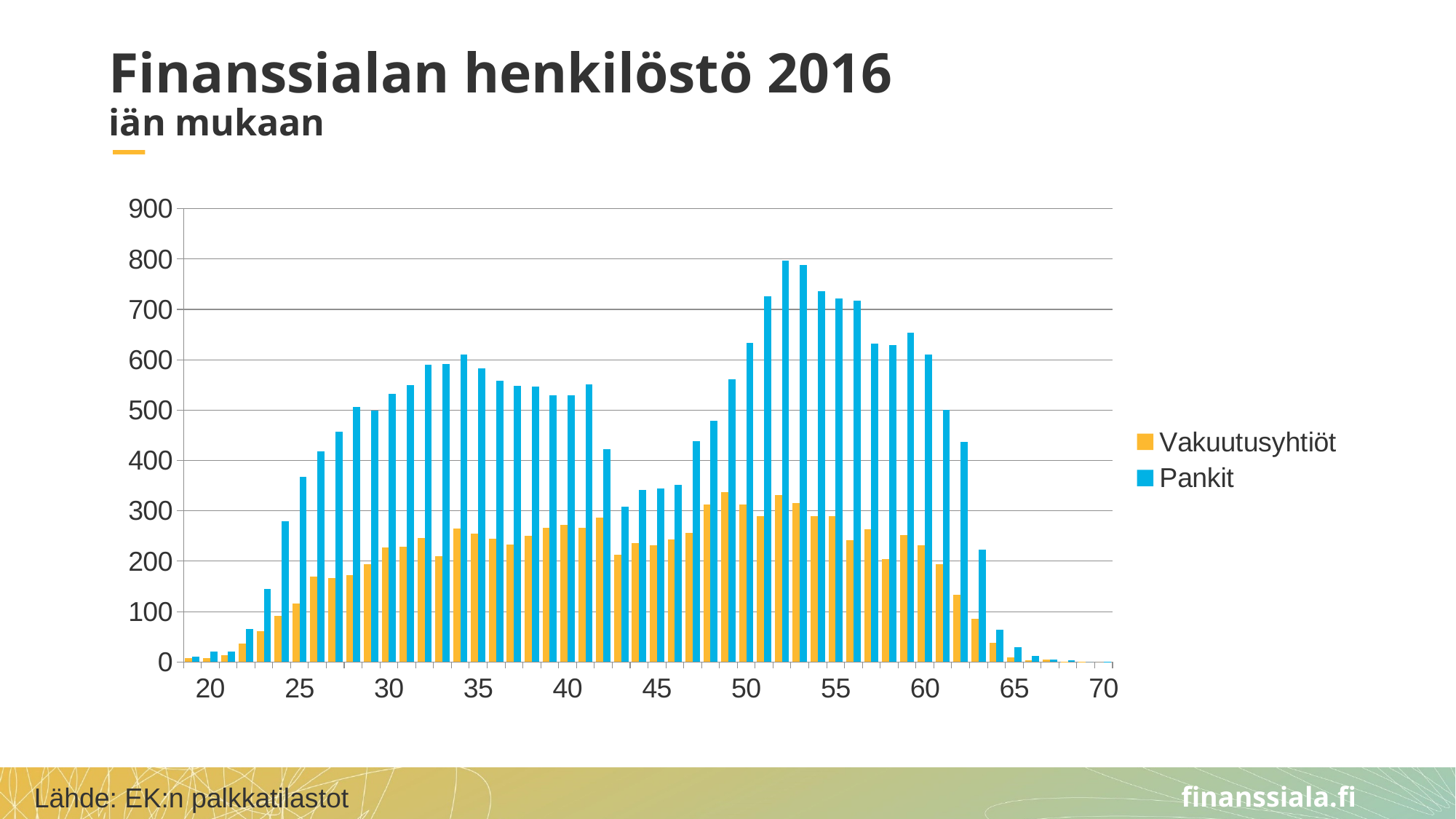
Is the Pankit value at age 45 greater or less than 400? less At age 40, which series has the larger value, Pankit or Vakuutusyhtiöt? Pankit What is the title of the chart on the slide? Finanssialan henkilöstö 2016 iän mukaan Is the Pankit value at age 52 greater or less than 700? greater Is the Vakuutusyhtiöt value at age 25 greater or less than 200? less What kind of chart is shown on the slide? bar chart Do the Pankit values rise or fall from age 63 to age 68? fall Do the Pankit values rise or fall from age 20 to age 30? rise Which series is shown in blue? Pankit How many series does the legend list? 2 For the Pankit series, which is larger: the value at age 52 or the value at age 34? age 52